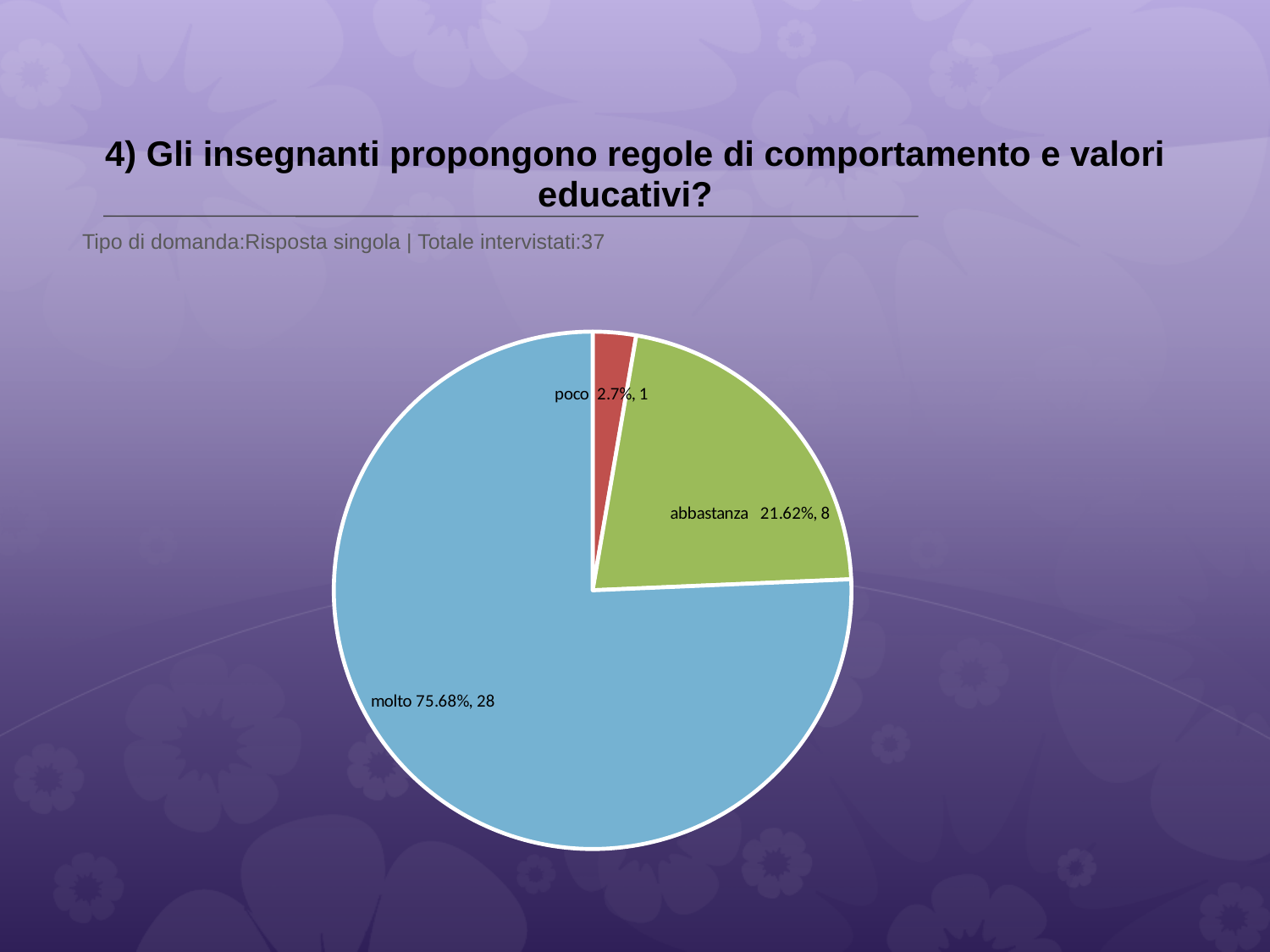
How many respondents answered 'molto'? 28 Which slice is larger, 'abbastanza' or 'poco'? abbastanza What kind of chart is shown on the slide? pie chart How many slices does the pie chart have? 3 Which category has the smallest slice? poco What is the difference in respondent count between 'molto' and 'abbastanza'? 20 What percentage share does the 'molto' slice have? 75.68% How many respondents answered 'poco'? 1 How many respondents answered 'abbastanza'? 8 What percentage share does the 'abbastanza' slice have? 21.62% Which category has the largest slice? molto What percentage share does the 'poco' slice have? 2.7%